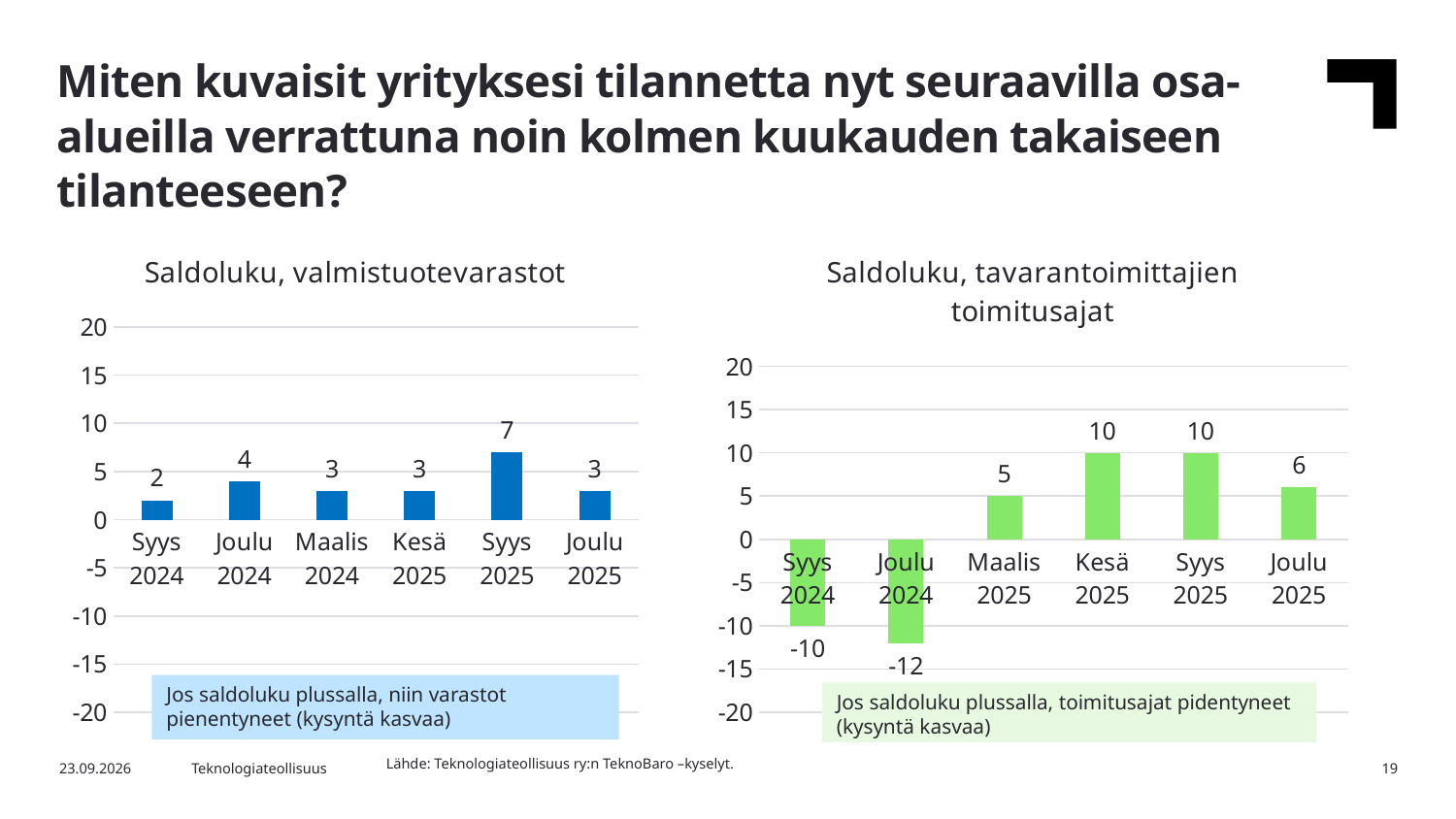
In the chart titled 'Saldoluku, tavarantoimittajien toimitusajat', which is larger, the value for Syys 2024 or the value for Maalis 2025? Maalis 2025 In the chart titled 'Saldoluku, valmistuotevarastot', how many periods are shown on the x axis? 6 In the chart titled 'Saldoluku, valmistuotevarastot', which period has the lowest value? Syys 2024 In the chart titled 'Saldoluku, tavarantoimittajien toimitusajat', what is the difference between the values for Kesä 2025 and Maalis 2025? 5 In the chart titled 'Saldoluku, valmistuotevarastot', what is the value for Joulu 2024? 4 In the chart titled 'Saldoluku, valmistuotevarastot', what is the difference between the values for Syys 2025 and Joulu 2025? 4 In the chart titled 'Saldoluku, tavarantoimittajien toimitusajat', what is the value for Joulu 2025? 6 In the chart titled 'Saldoluku, valmistuotevarastot', which period has the highest value? Syys 2025 In the chart titled 'Saldoluku, valmistuotevarastot', what is the value for Syys 2025? 7 What type of chart is the chart titled 'Saldoluku, tavarantoimittajien toimitusajat'? Bar chart In the chart titled 'Saldoluku, tavarantoimittajien toimitusajat', what is the value for Joulu 2024? -12 In the chart titled 'Saldoluku, tavarantoimittajien toimitusajat', which period has the lowest value? Joulu 2024